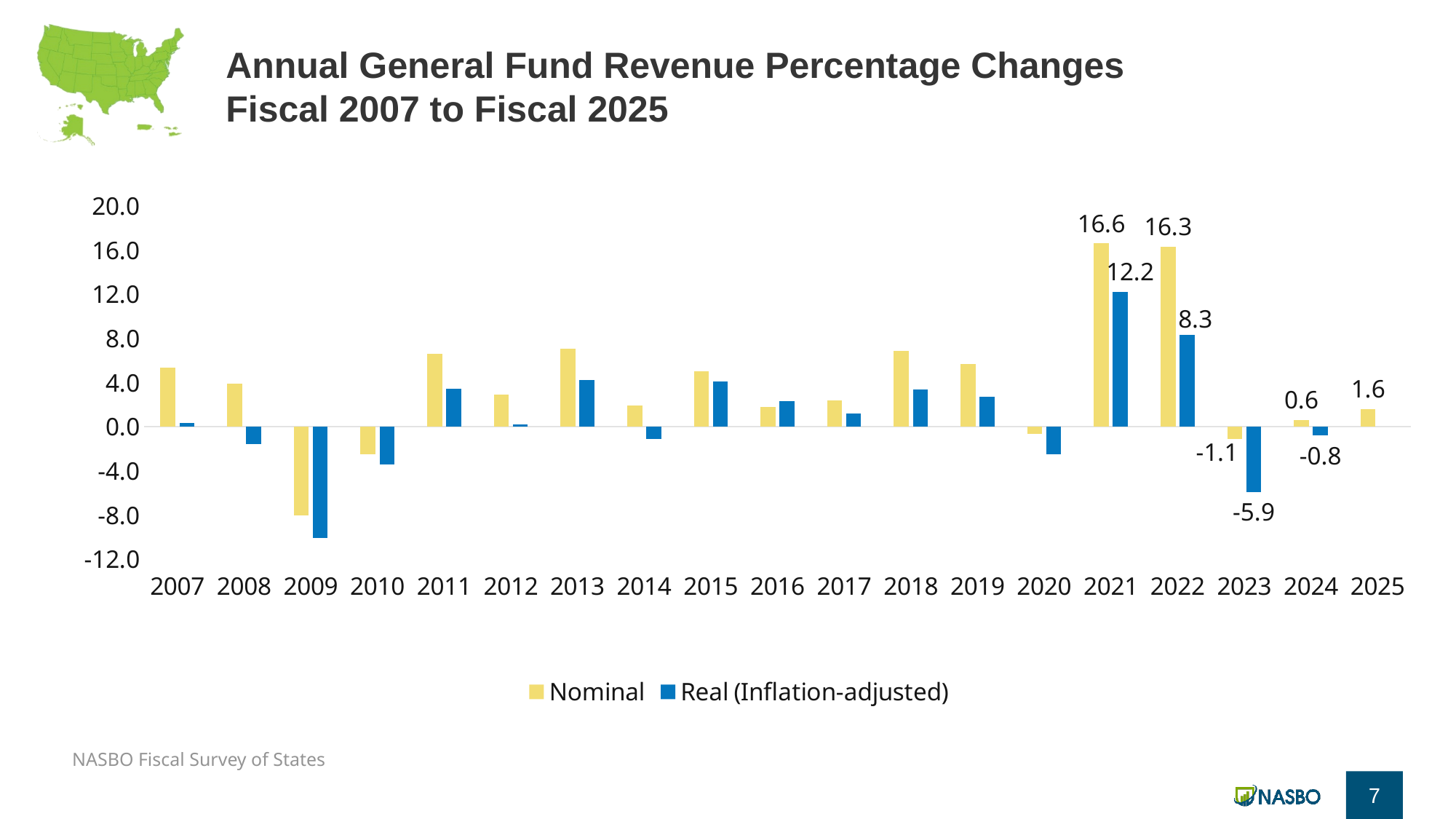
How many series does the legend list? 2 What kind of chart is shown on the slide? bar chart Which year has the highest Nominal value? 2021 Which year has the lowest Real (Inflation-adjusted) value? 2009 What is the Real (Inflation-adjusted) value for 2023? -5.9 What is the Nominal value for 2021? 16.6 How many years are shown on the x axis? 19 Which is larger, the Nominal value for 2021 or the Nominal value for 2022? 2021 What is the Real (Inflation-adjusted) value for 2022? 8.3 What is the difference between the Nominal and Real (Inflation-adjusted) values for 2021? 4.4 Is the Nominal value for 2009 greater or less than -4.0? less What is the Nominal value for 2025? 1.6